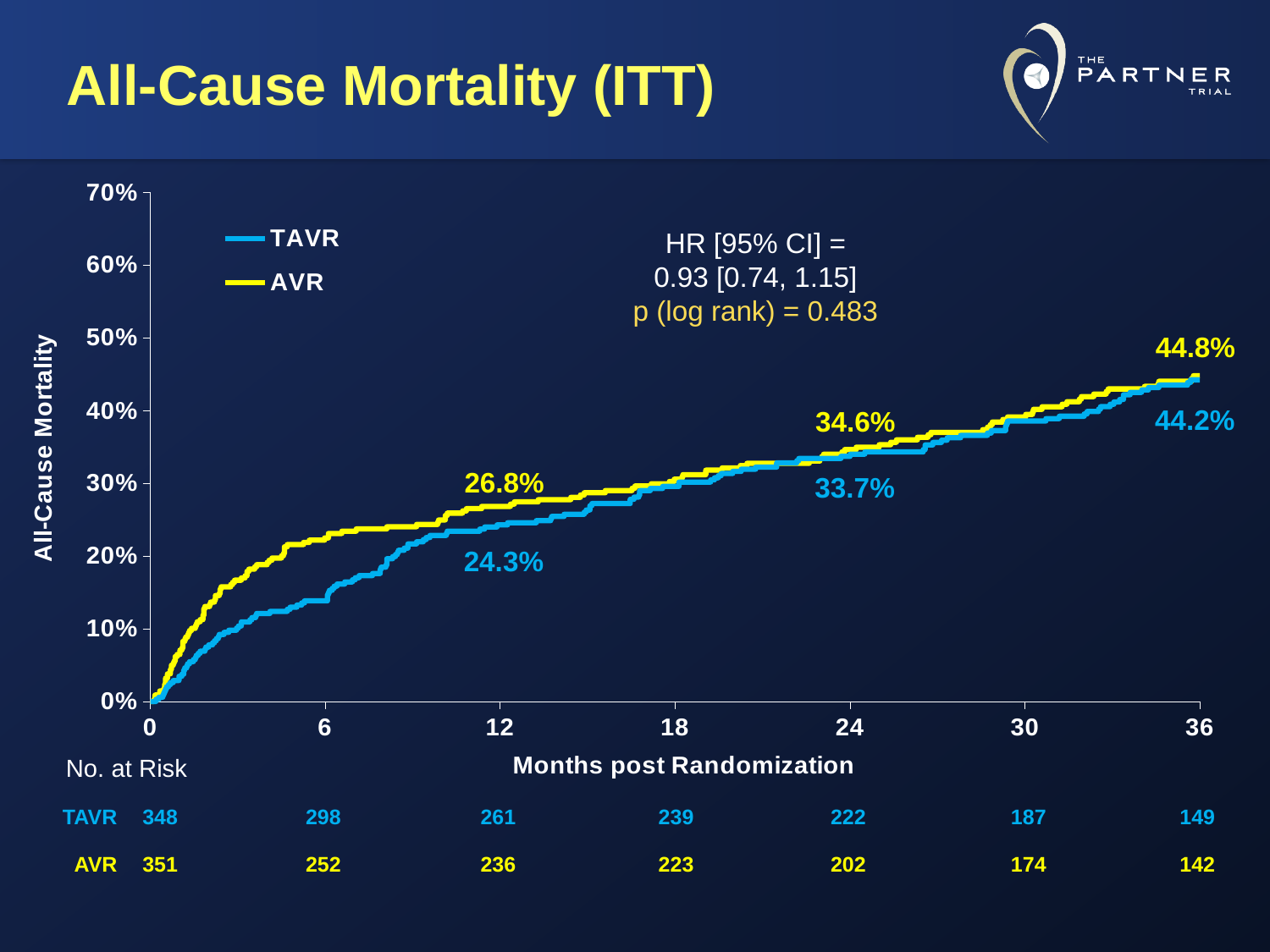
What is the all-cause mortality for TAVR at 24 months? 33.7% What is the all-cause mortality for AVR at 12 months? 26.8% Is the AVR mortality at 6 months greater or less than 20%? greater What is the p (log rank) value shown on the chart? 0.483 What is the all-cause mortality for TAVR at 12 months? 24.3% How many series does the legend list? 2 Is the TAVR mortality at 6 months greater or less than 20%? less What is the all-cause mortality for AVR at 36 months? 44.8% What is the difference between the AVR and TAVR mortality values labelled at 24 months? 0.9% What is the difference between the AVR and TAVR mortality values labelled at 12 months? 2.5% Which series has the higher labelled mortality at 12 months, TAVR or AVR? AVR Do the mortality curves rise or fall as months post randomization increase? rise